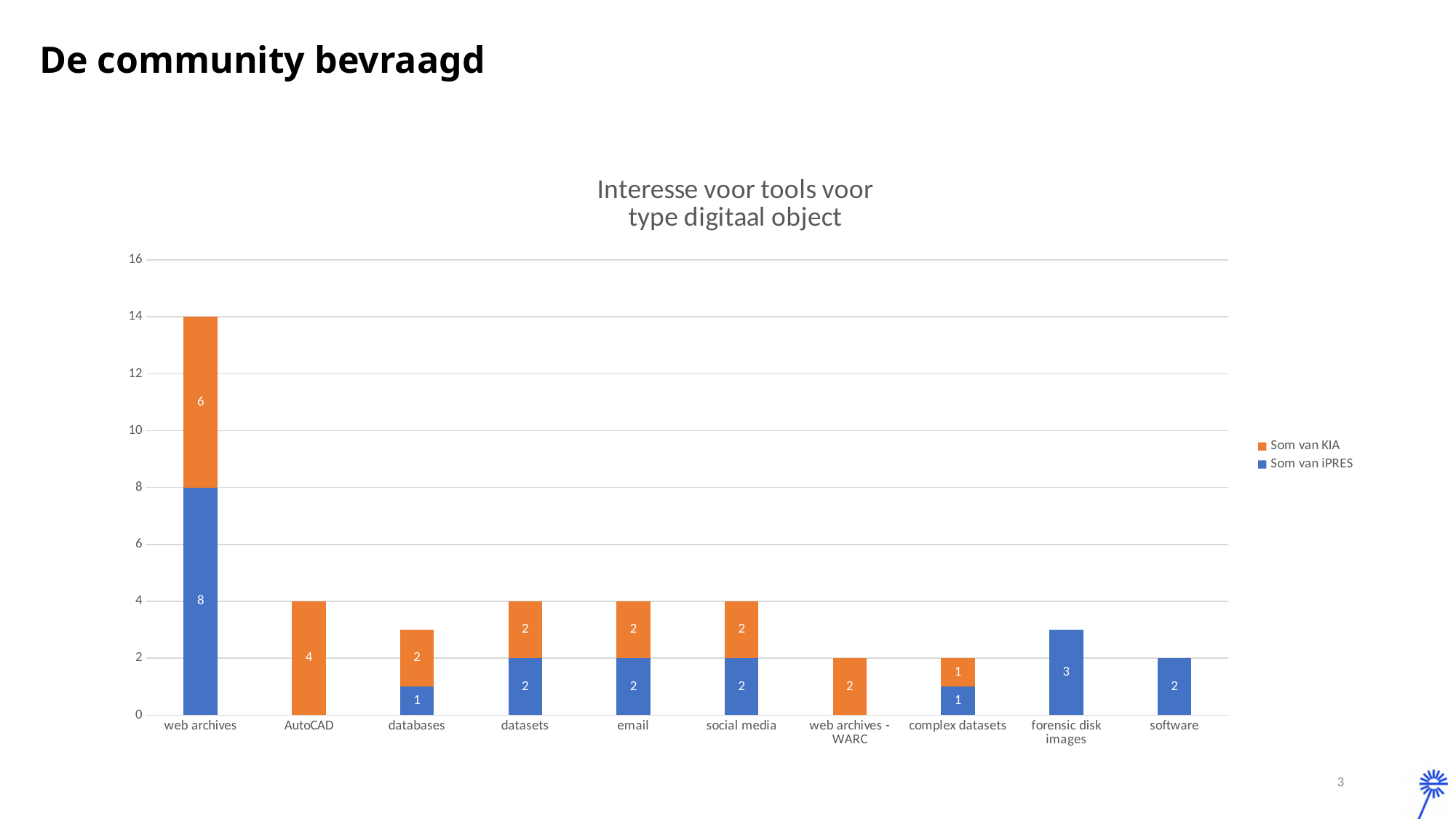
What is the total of the stacked bar for web archives? 14 Which is larger: the Som van iPRES value for forensic disk images or the Som van iPRES value for software? forensic disk images What is the Som van KIA value for AutoCAD? 4 How many series does the legend list? 2 What type of chart is shown on the slide? stacked bar chart What is the total of the stacked bar for databases? 3 What is the Som van iPRES value for forensic disk images? 3 How many categories are shown on the x axis? 10 What is the difference between the Som van KIA value for web archives and the Som van KIA value for AutoCAD? 2 Which category has the highest total stacked bar? web archives What is the Som van iPRES value for web archives? 8 What is the Som van KIA value for complex datasets? 1